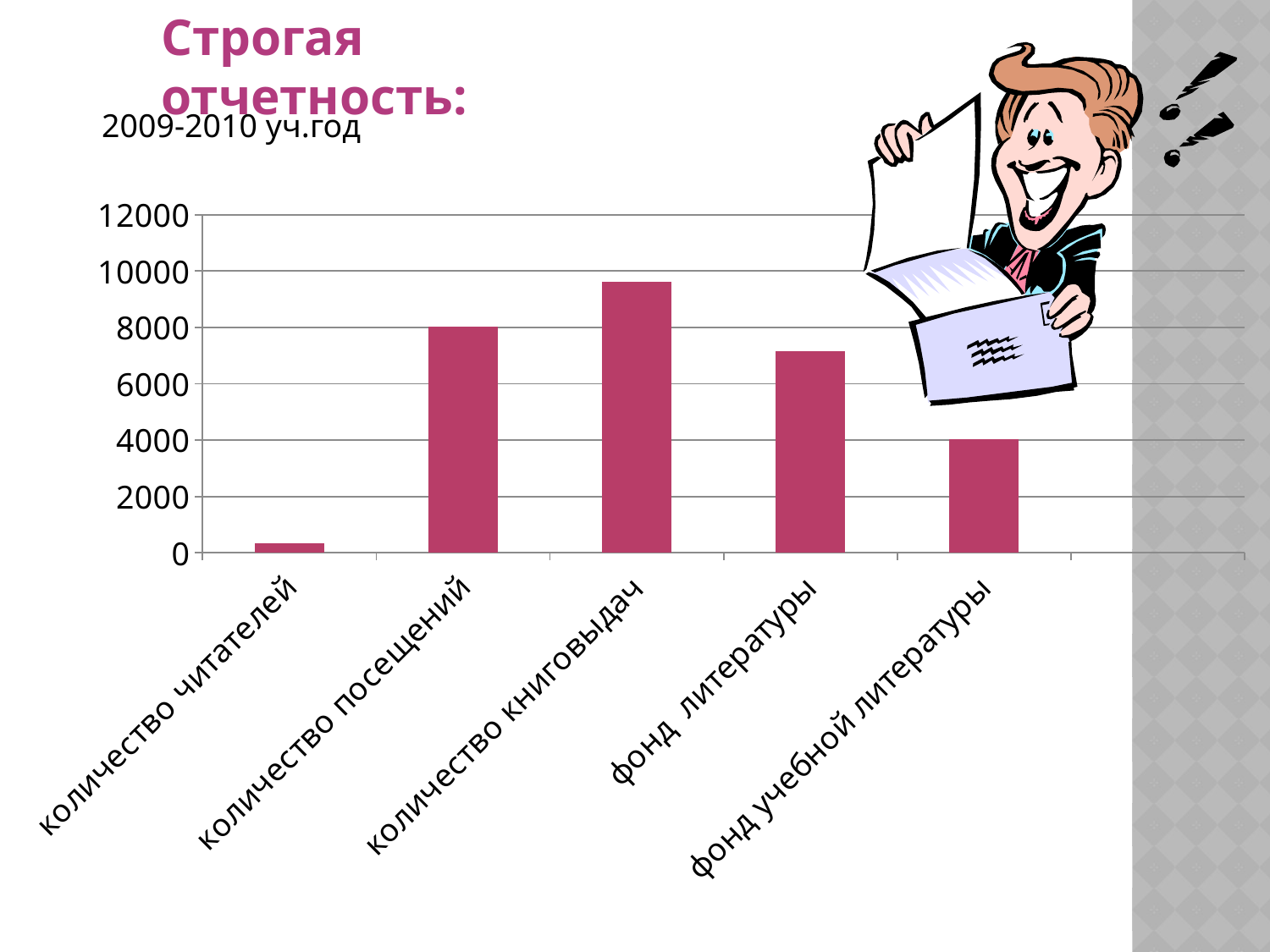
What academic year is the chart labelled with? 2009-2010 уч.год Which category has the lowest value in the chart? количество читателей Which category has the highest value in the chart? количество книговыдач Is the value for количество книговыдач greater or less than 8000? greater Which is larger, the value for фонд литературы or the value for фонд учебной литературы? фонд литературы Which is larger, the value for количество посещений or the value for количество книговыдач? количество книговыдач Is the value for фонд литературы greater or less than 8000? less Is the value for количество читателей greater or less than 2000? less What kind of chart is shown on the slide? bar chart How many categories are plotted in the chart? 5